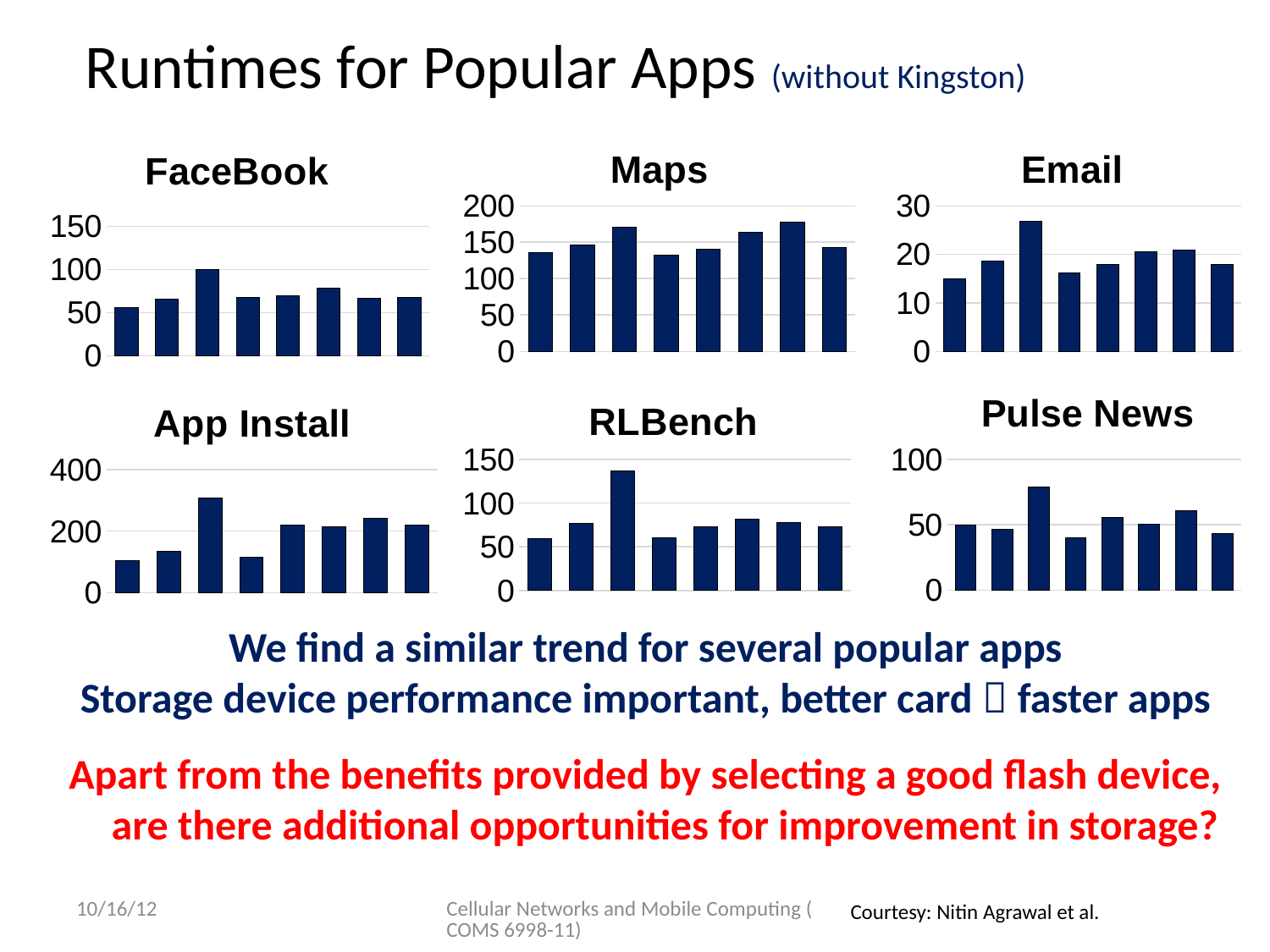
In the Maps chart, how many bars are plotted? 8 In the FaceBook chart, is the value of the first bar greater or less than 100? less In the RLBench chart, is the value of the third bar greater or less than 100? greater In the App Install chart, which bar is the highest? the third bar In the Maps chart, is the value of the first bar greater or less than 100? greater In the Pulse News chart, which bar is the highest? the third bar What is the title of the chart in the top-right position of the slide? Email In the Maps chart, which is larger: the seventh bar or the fourth bar? the seventh bar How many charts are shown on the slide? 6 What kind of chart is the FaceBook chart? bar chart